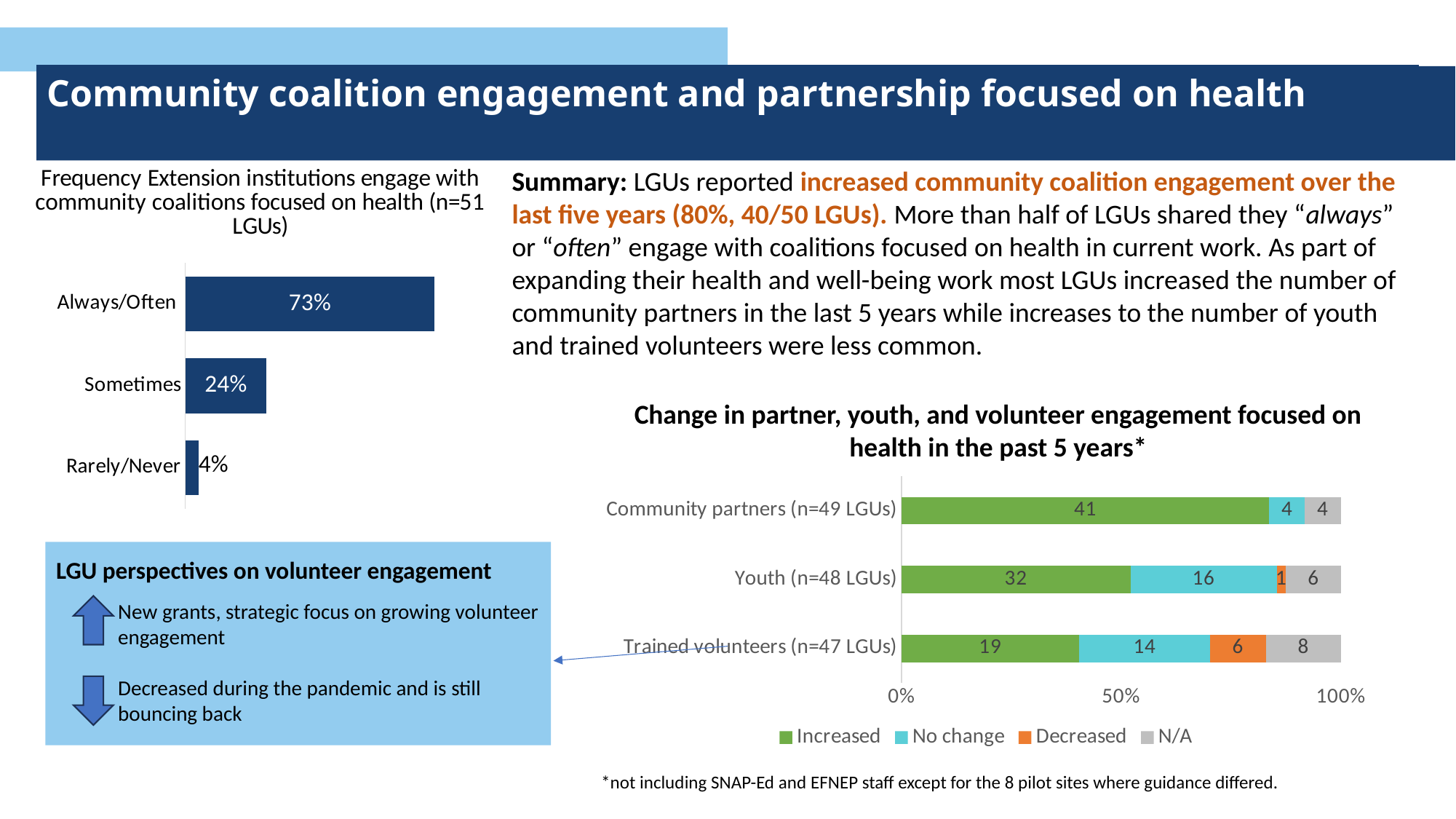
In the chart titled 'Change in partner, youth, and volunteer engagement focused on health in the past 5 years', what is the No change value for Youth (n=48 LGUs)? 16 In the chart titled 'Frequency Extension institutions engage with community coalitions focused on health', what is the difference between the Always/Often and Sometimes values? 49% In the chart titled 'Frequency Extension institutions engage with community coalitions focused on health', what is the value for Always/Often? 73% What kind of chart is the chart titled 'Change in partner, youth, and volunteer engagement focused on health in the past 5 years'? Stacked bar chart In the chart titled 'Change in partner, youth, and volunteer engagement focused on health in the past 5 years', what is the total of the Trained volunteers (n=47 LGUs) bar? 47 In the chart titled 'Frequency Extension institutions engage with community coalitions focused on health', what is the value for Sometimes? 24% In the chart titled 'Frequency Extension institutions engage with community coalitions focused on health', which category has the lowest value? Rarely/Never In the chart titled 'Frequency Extension institutions engage with community coalitions focused on health', how many categories are shown? 3 In the chart titled 'Change in partner, youth, and volunteer engagement focused on health in the past 5 years', which category has the highest Increased value? Community partners (n=49 LGUs) In the chart titled 'Change in partner, youth, and volunteer engagement focused on health in the past 5 years', what is the Decreased value for Trained volunteers (n=47 LGUs)? 6 In the chart titled 'Change in partner, youth, and volunteer engagement focused on health in the past 5 years', how many series does the legend list? 4 In the chart titled 'Change in partner, youth, and volunteer engagement focused on health in the past 5 years', what is the Increased value for Community partners (n=49 LGUs)? 41